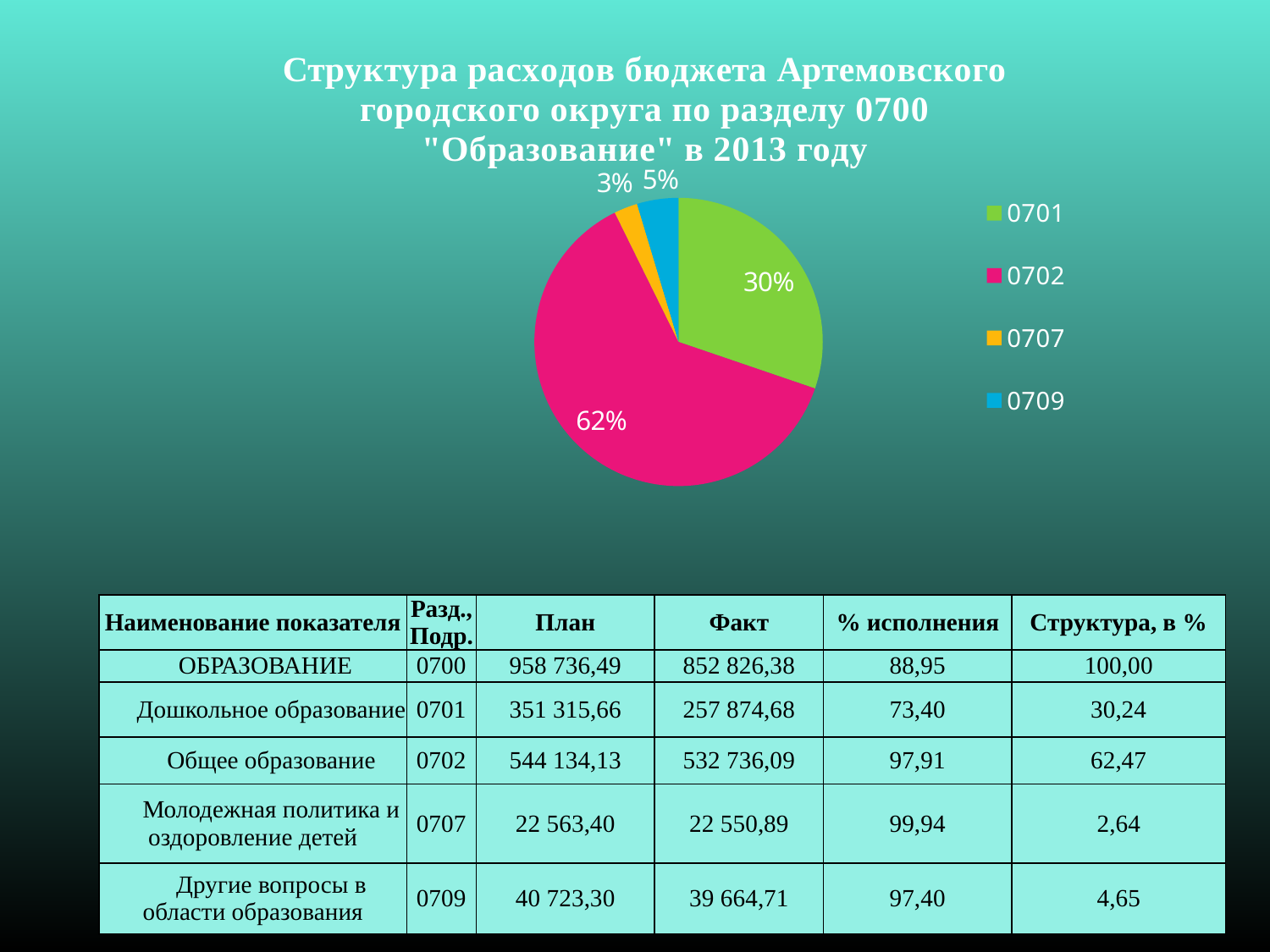
Which slice is larger, 0709 or 0707? 0709 Which category has the smallest slice of the pie? 0707 How many entries does the legend list? 4 What share of the pie does 0707 have? 3% Which category has the largest slice of the pie? 0702 What share of the pie does 0709 have? 5% How many slices does the pie chart have? 4 What is the difference in percentage points between the 0702 slice and the 0701 slice? 32 What colour is the slice for 0702? magenta (pink) What share of the pie does 0701 have? 30% What kind of chart is shown on the slide? pie chart What share of the pie does 0702 have? 62%